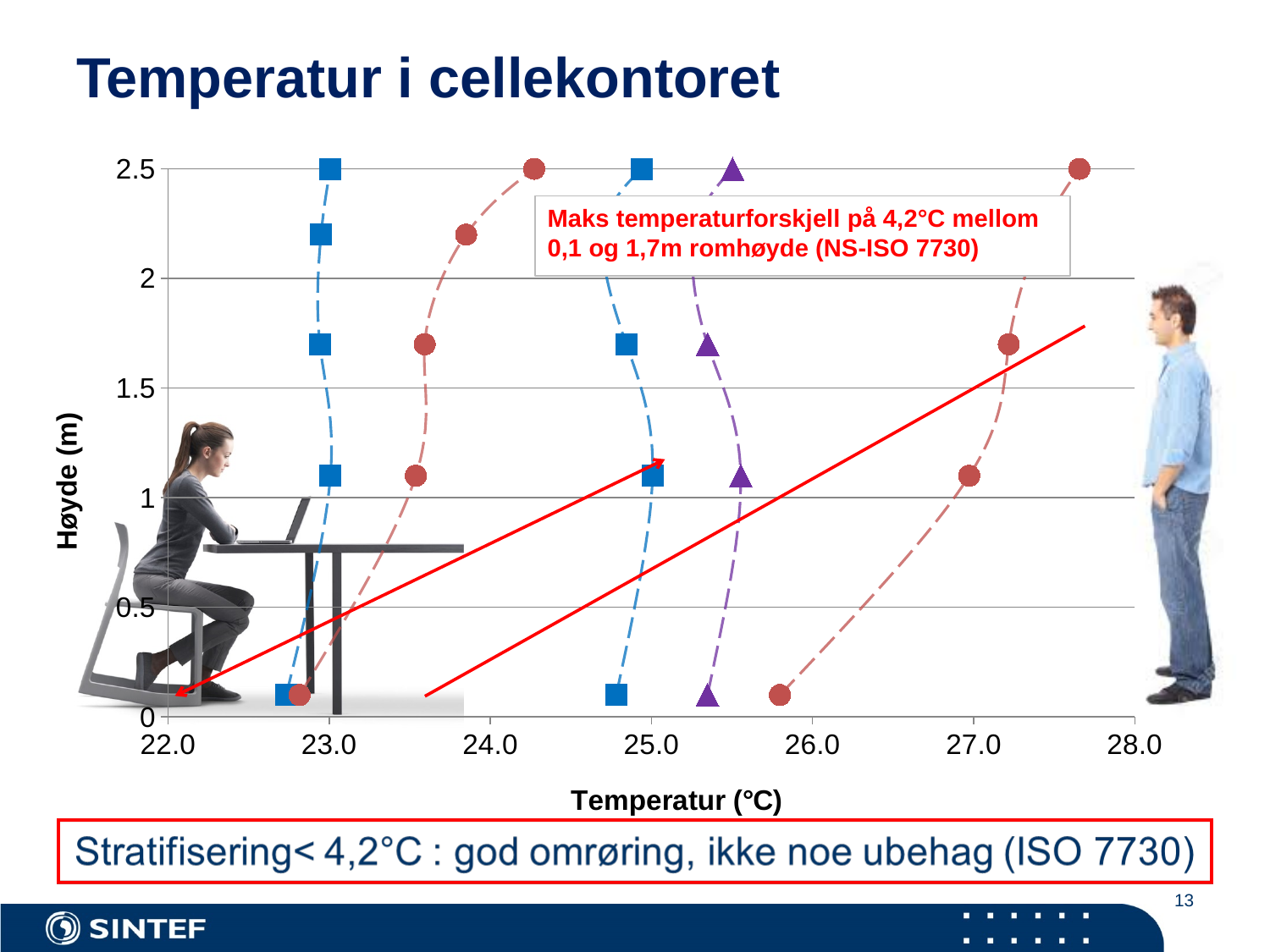
At a height of 1.1 m, is the rightmost plotted temperature greater or less than 26.0? greater How many height levels (points per curve) are plotted on the chart? 5 At a height of 0 m, is the leftmost plotted temperature greater or less than 23.0? less What is the title of the chart on the slide? Temperatur i cellekontoret What kind of chart is shown on the slide? line chart At a height of 2.5 m, which is larger: the leftmost plotted temperature or the rightmost plotted temperature? the rightmost At a height of 0 m, is the rightmost plotted temperature greater or less than 26.0? less What is the title of the x axis? Temperatur (°C) How many distinct data series (curves) are plotted on the chart? 5 At which height is the highest temperature on the chart plotted? 2.5 m For the curve furthest to the right, does the temperature rise or fall as height increases? rise